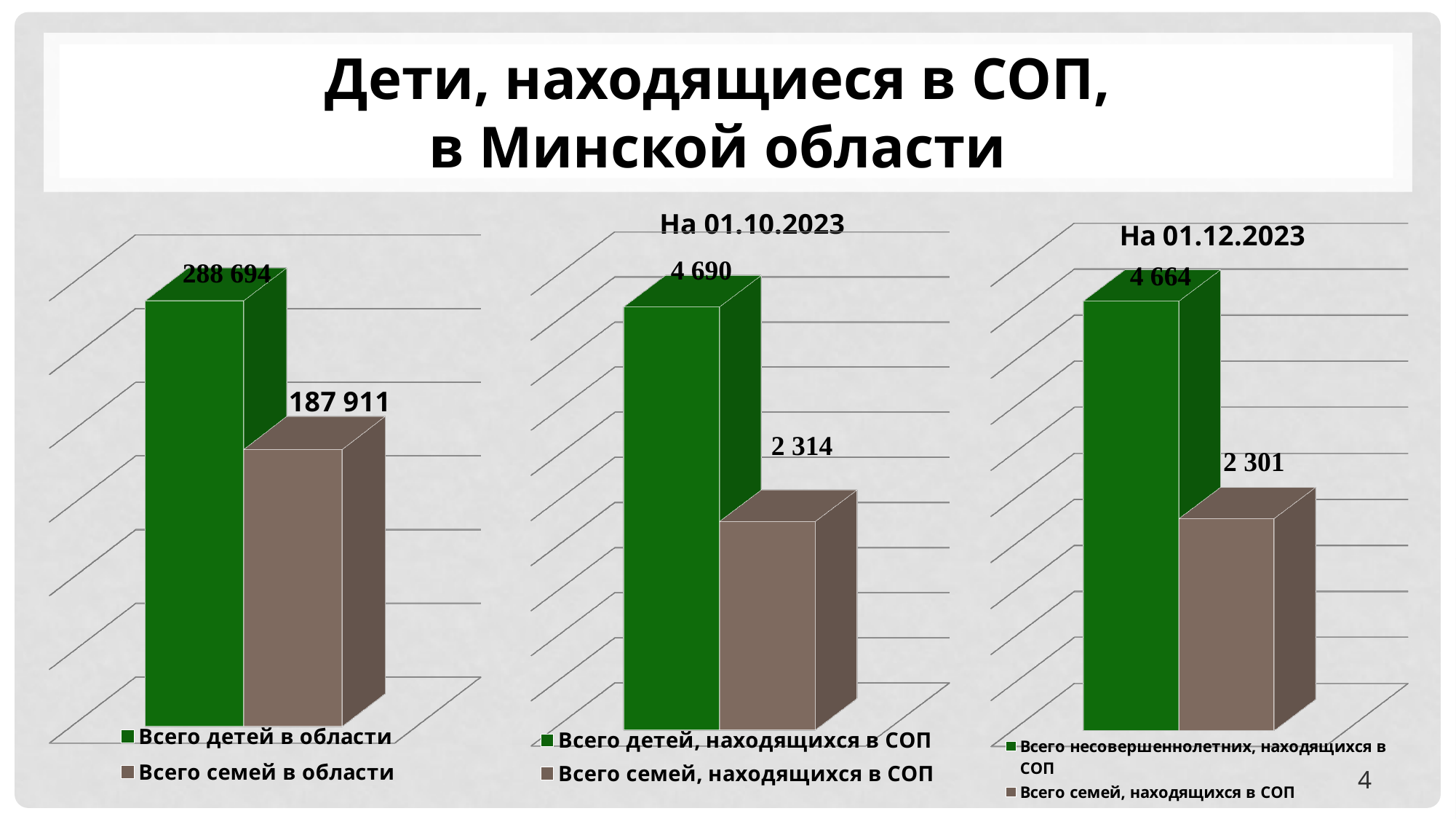
In the chart titled 'На 01.10.2023', what is the difference between the two values shown? 2 376 What colour is the bar for 'Всего семей, находящихся в СОП' in the chart titled 'На 01.12.2023'? Brown In the chart titled 'На 01.12.2023', which series has the larger value? Всего несовершеннолетних, находящихся в СОП In the chart titled 'На 01.12.2023', what is the value for 'Всего семей, находящихся в СОП'? 2 301 How many series does the legend of the chart titled 'На 01.10.2023' list? 2 In the left chart, what is the value for 'Всего детей в области'? 288 694 In the chart titled 'На 01.10.2023', what is the value for 'Всего детей, находящихся в СОП'? 4 690 What kind of chart is the left chart? Bar chart In the chart titled 'На 01.12.2023', what is the value for 'Всего несовершеннолетних, находящихся в СОП'? 4 664 In the left chart, what is the difference between 'Всего детей в области' and 'Всего семей в области'? 100 783 In the chart titled 'На 01.10.2023', what is the value for 'Всего семей, находящихся в СОП'? 2 314 In the left chart, what is the value for 'Всего семей в области'? 187 911